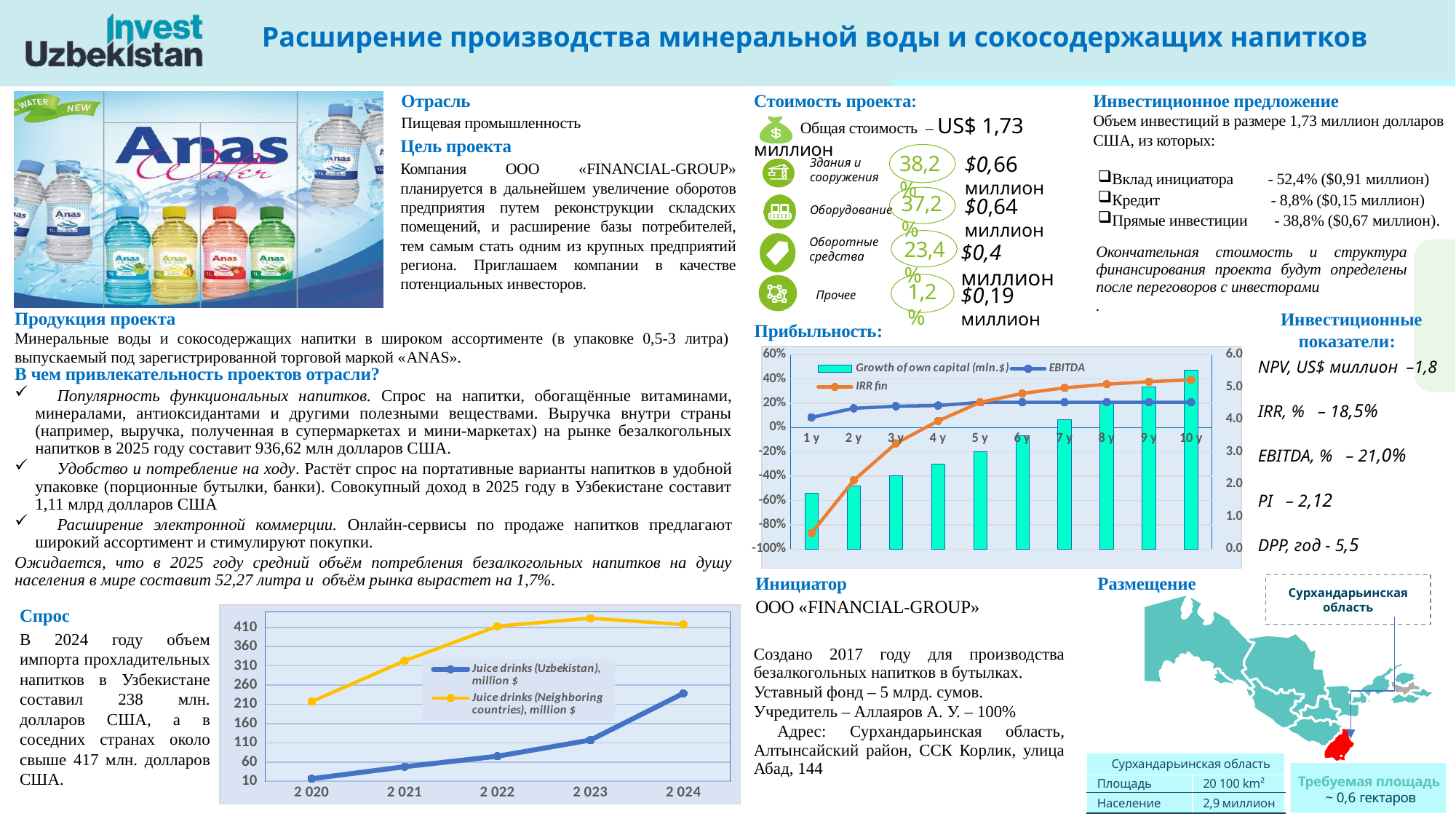
How many series does the legend of the 'Прибыльность' chart list? 3 How many series does the legend of the 'Спрос' chart list? 2 In the 'Спрос' chart, does the Juice drinks (Uzbekistan) series rise or fall from 2020 to 2024? rise In the 'Спрос' chart, is the value for Juice drinks (Neighboring countries) in 2024 greater or less than 360? greater In the 'Спрос' chart, is the value for Juice drinks (Uzbekistan) in 2020 greater or less than 60? less In the 'Прибыльность' chart, in which year is the Growth of own capital bar the tallest? 10 y In the 'Спрос' chart, which series is higher in 2022: Juice drinks (Uzbekistan) or Juice drinks (Neighboring countries)? Juice drinks (Neighboring countries) In the 'Прибыльность' chart, is the IRR fin value at 1 y greater or less than -60%? less How many years are plotted on the x axis of the 'Спрос' chart? 5 How many years are shown on the x axis of the 'Прибыльность' chart? 10 In the 'Спрос' chart, in which year is Juice drinks (Neighboring countries) at its highest? 2023 What kind of chart is the 'Спрос' chart at the bottom of the slide? line chart